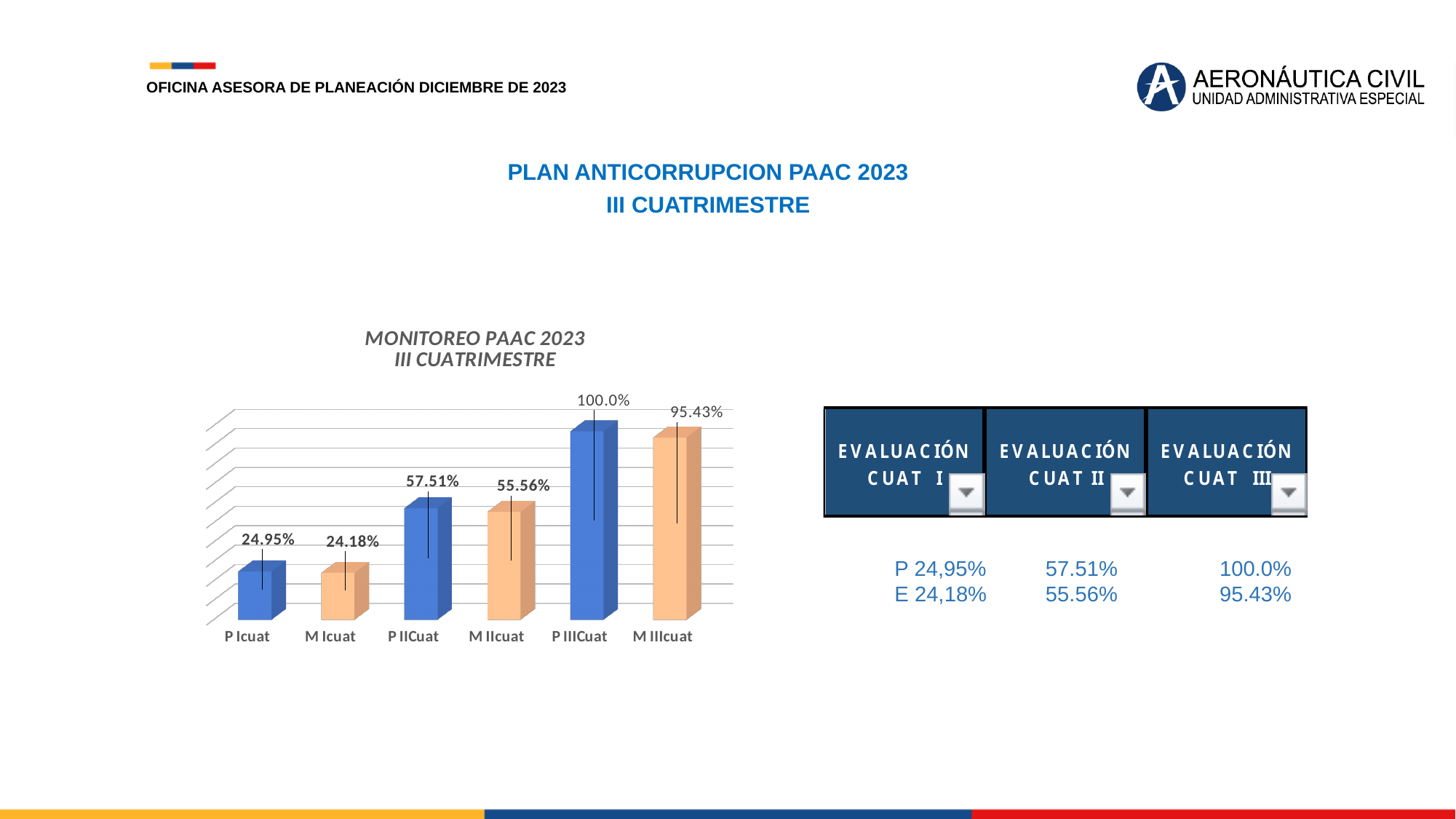
What is the value for M Icuat in the chart? 24.18% What is the value for P IICuat in the MONITOREO PAAC 2023 III CUATRIMESTRE chart? 57.51% Which is larger, the value for P IICuat or the value for M IIcuat? P IICuat What is the difference between the values for P IICuat and M IIcuat? 1.95% What is the value for M IIIcuat in the chart? 95.43% What is the value for P IIICuat in the chart? 100.0% What is the difference between the values for P IIICuat and M IIIcuat? 4.57% What kind of chart is shown on the slide? Bar chart Which category has the lowest value in the chart? M Icuat Which category has the highest value in the chart? P IIICuat How many bars are shown in the chart? 6 What is the title of the chart on the slide? MONITOREO PAAC 2023 III CUATRIMESTRE